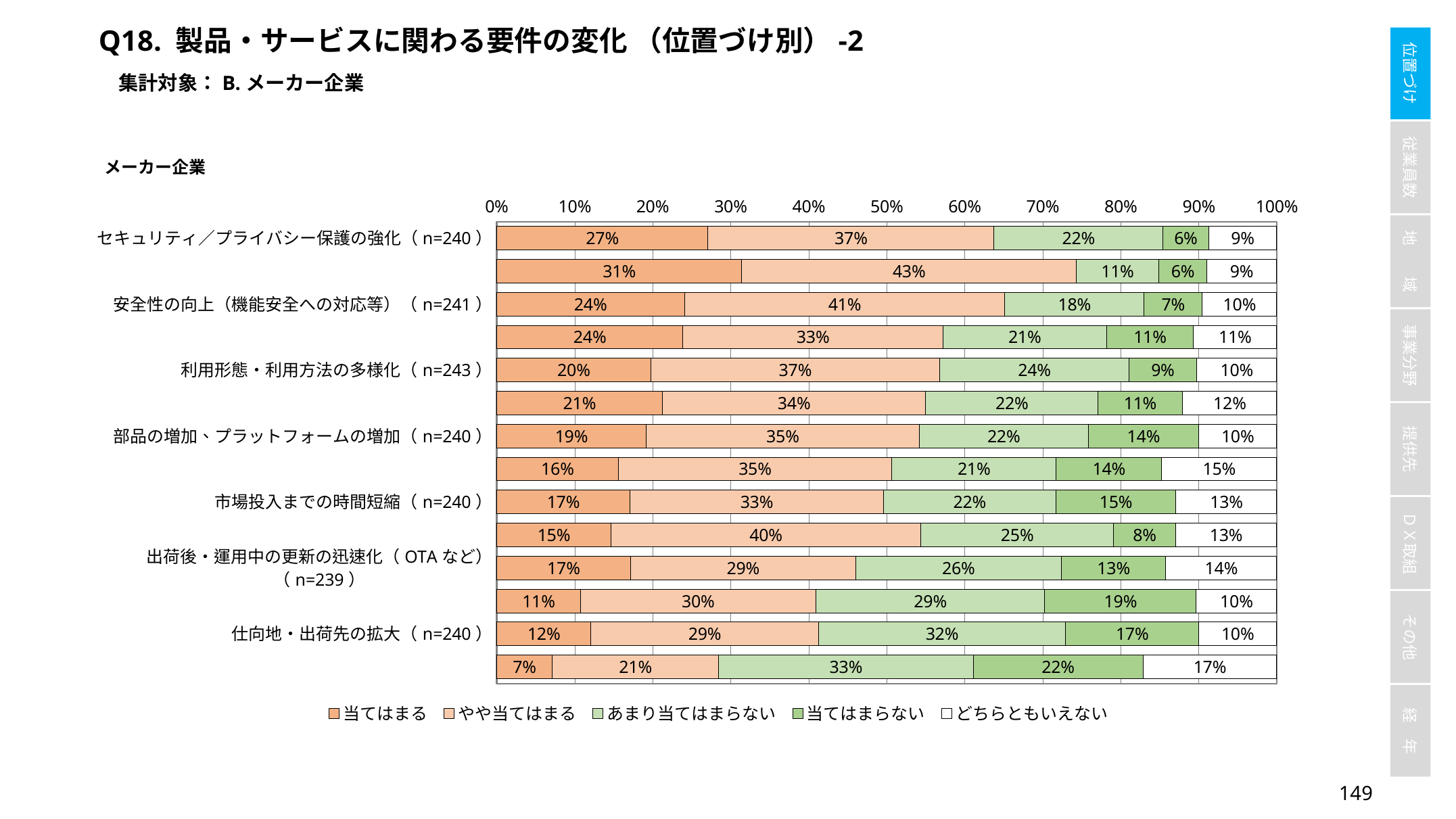
What is the difference between the 当てはまる values for セキュリティ／プライバシー保護の強化 (27%) and 市場投入までの時間短縮 (17%)? 10 percentage points What is the last legend entry shown below the chart? どちらともいえない How many series does the legend list? 5 Which is larger: the 当てはまらない value for 部品の増加、プラットフォームの増加 or for 利用形態・利用方法の多様化? 部品の増加、プラットフォームの増加 What kind of chart is shown on the slide? Stacked horizontal bar chart What percentage of respondents answered 当てはまる for セキュリティ／プライバシー保護の強化 (n=240)? 27% Among the labeled categories, which has the highest 当てはまる share? セキュリティ／プライバシー保護の強化 What is the あまり当てはまらない value for 仕向地・出荷先の拡大 (n=240)? 32% What is the どちらともいえない value for 出荷後・運用中の更新の迅速化（OTAなど）(n=239)? 14% Among the labeled categories, which has the lowest 当てはまる share? 仕向地・出荷先の拡大 What is the total of the stacked bar for 市場投入までの時間短縮 (n=240) (17% + 33% + 22% + 15% + 13%)? 100% What is the やや当てはまる value for 安全性の向上（機能安全への対応等）(n=241)? 41%